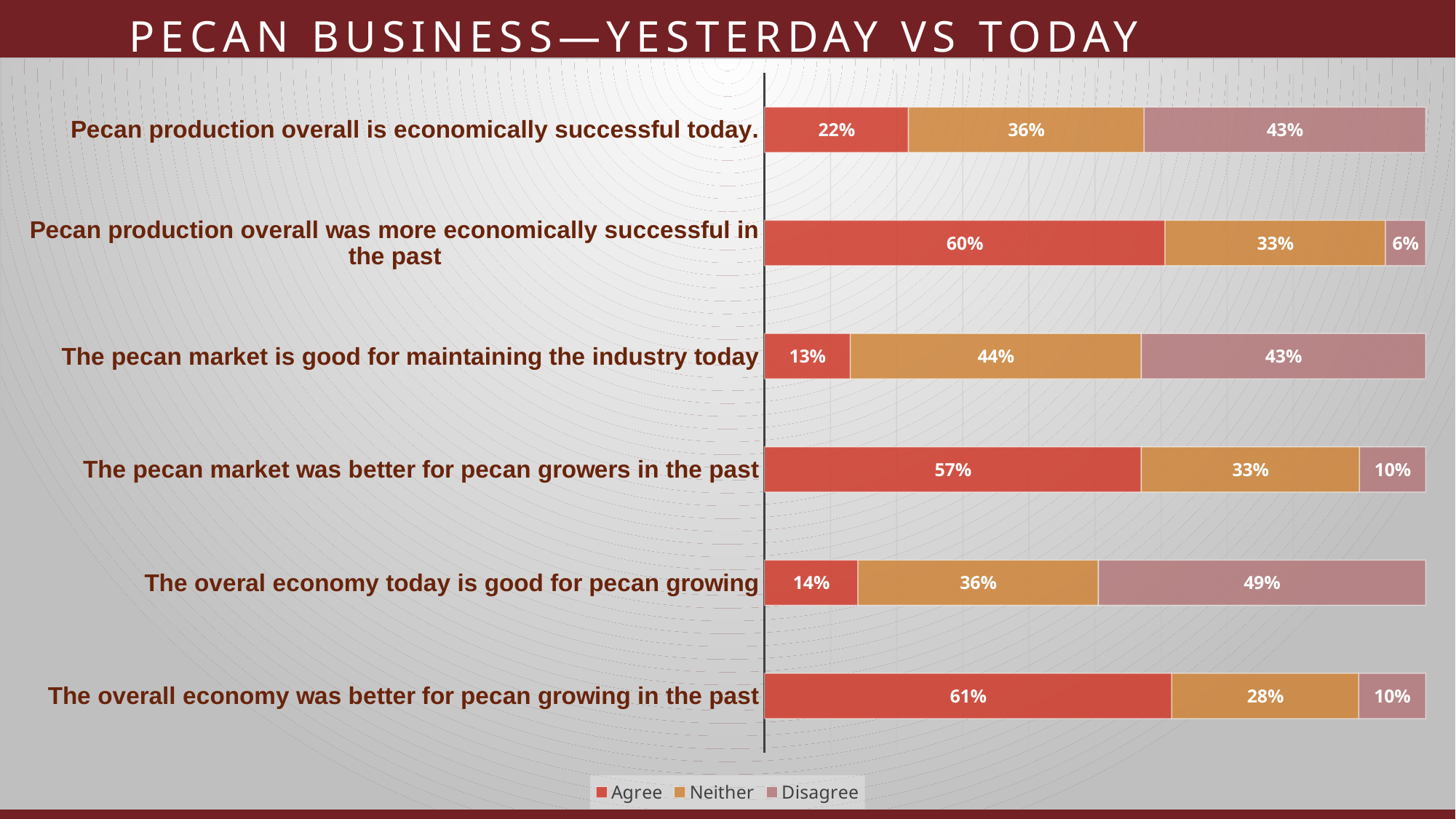
What percentage agreed that pecan production overall is economically successful today? 22% How many statements (categories) are plotted in the chart? 6 What is the Neither value for 'The pecan market is good for maintaining the industry today'? 44% Which statement has the highest Agree percentage? The overall economy was better for pecan growing in the past What is the difference between the Agree values for 'The overall economy was better for pecan growing in the past' and 'The overal economy today is good for pecan growing'? 47% What is the title of the slide? PECAN BUSINESS—YESTERDAY VS TODAY What is the Disagree value for 'The overal economy today is good for pecan growing'? 49% What is the total of the stacked bar for 'The pecan market is good for maintaining the industry today'? 100% Which is larger: the Agree value for 'Pecan production overall was more economically successful in the past' or the Agree value for 'The pecan market was better for pecan growers in the past'? Pecan production overall was more economically successful in the past What kind of chart is shown on the slide? Stacked bar chart How many series does the legend list? 3 Which statement has the lowest Disagree percentage? Pecan production overall was more economically successful in the past